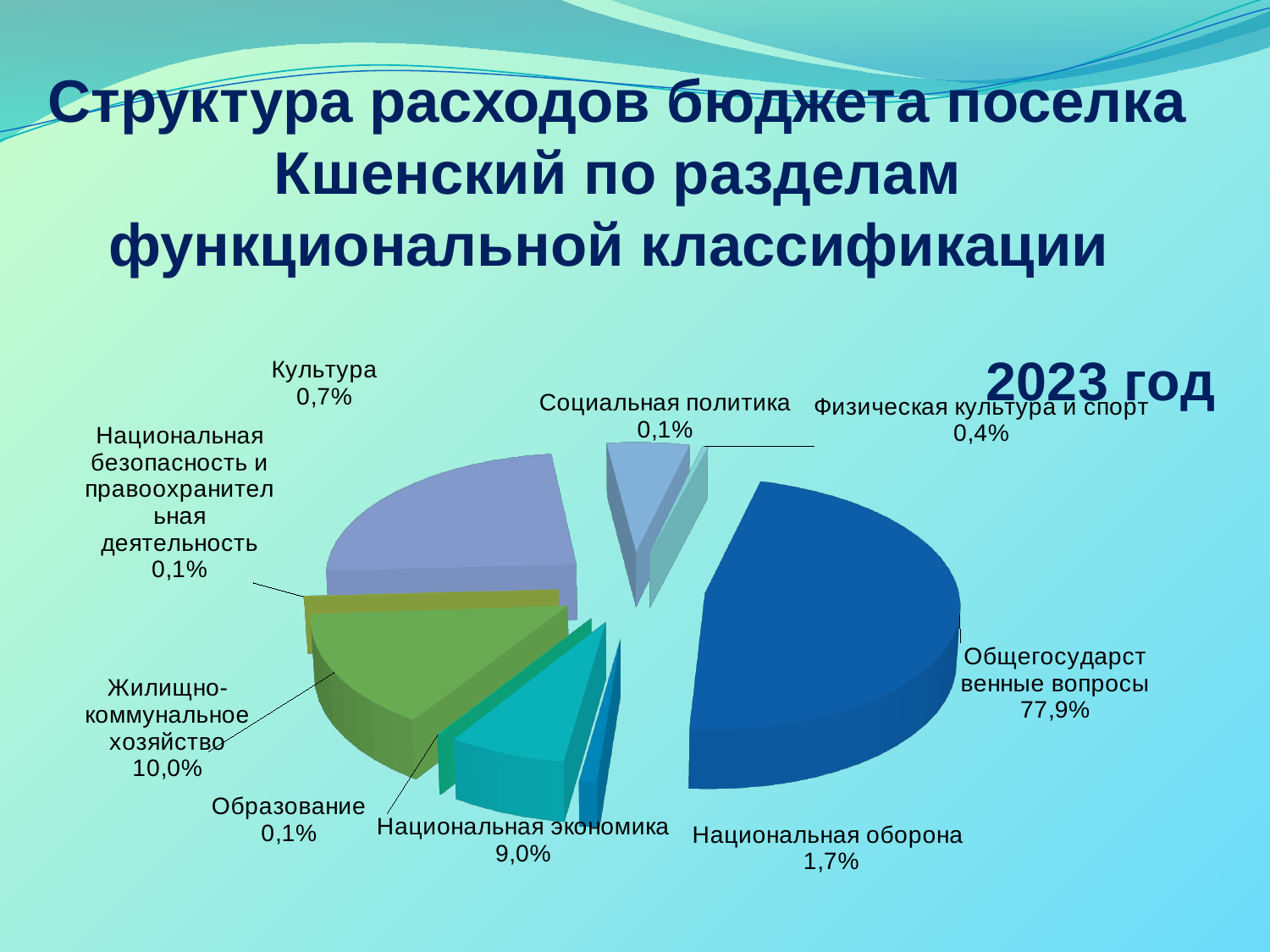
What is the value for Культура? 0,7% What is the value for Национальная экономика? 9,0% What is the value for Национальная оборона? 1,7% What kind of chart is shown on the slide? pie chart What is the value for Жилищно-коммунальное хозяйство? 10,0% What is the difference between the shares of Общегосударственные вопросы and Жилищно-коммунальное хозяйство? 67,9% Which is larger, Жилищно-коммунальное хозяйство or Национальная экономика? Жилищно-коммунальное хозяйство Which category has the largest share of the pie? Общегосударственные вопросы What share of expenditure goes to Общегосударственные вопросы? 77,9% How many categories are shown in the pie chart? 9 Which year does the chart refer to? 2023 год What is the value for Физическая культура и спорт? 0,4%